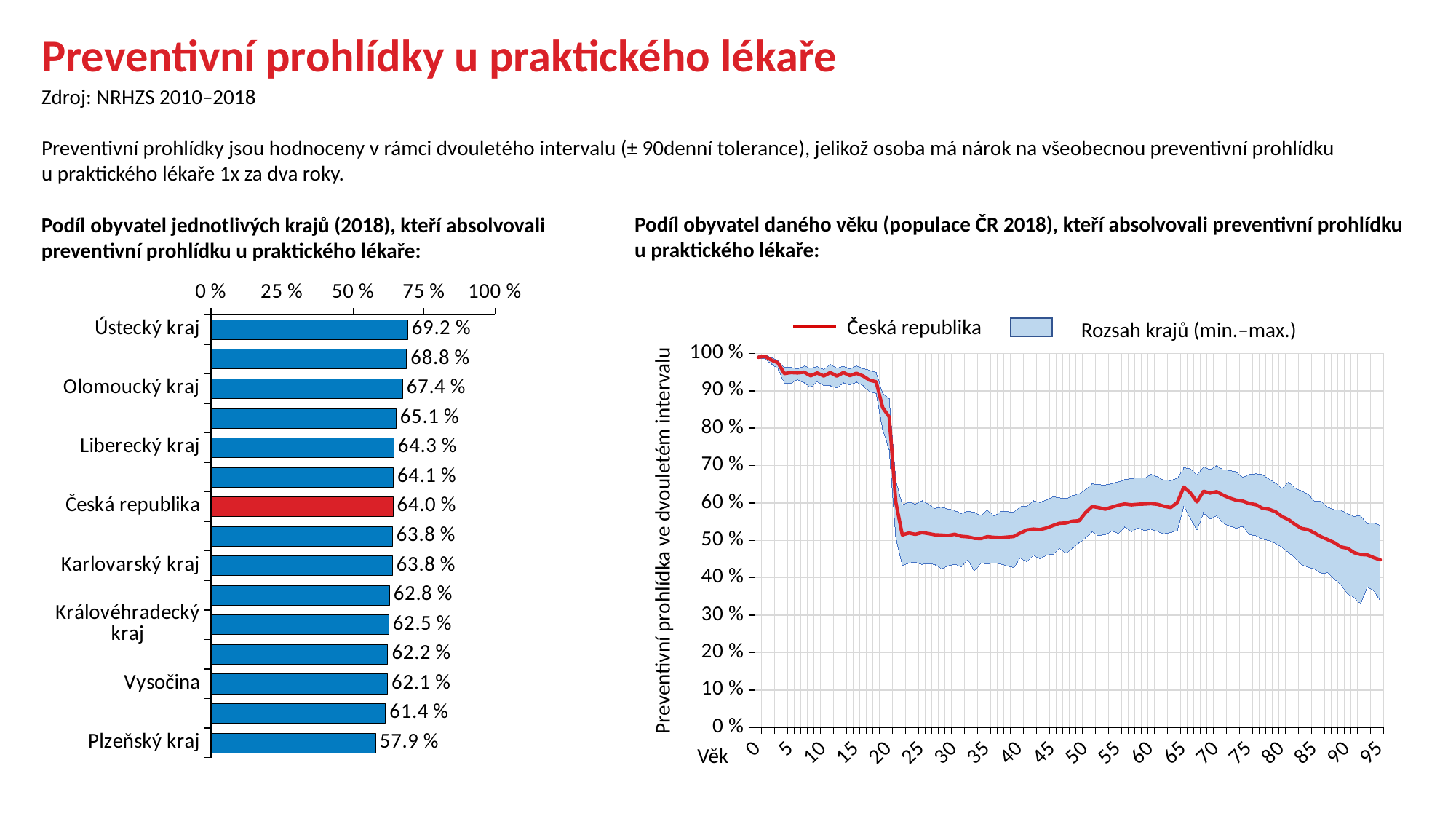
In the right chart, is the Česká republika value at age 0 greater or less than 90 %? greater In the left bar chart, how many bars are plotted? 15 In the left bar chart, which labelled region has the highest value? Ústecký kraj What type of chart is the chart on the left? Bar chart In the left bar chart, what is the value for Ústecký kraj? 69.2 % In the right chart, how many entries does the legend list? 2 In the left bar chart, which is larger: Olomoucký kraj or Liberecký kraj? Olomoucký kraj In the left bar chart, which labelled region has the lowest value? Plzeňský kraj In the left bar chart, what is the difference between Ústecký kraj and Plzeňský kraj? 11.3 % In the left bar chart, what is the value for Plzeňský kraj? 57.9 % In the right chart, is the Česká republika value at age 95 greater or less than 50 %? less In the left bar chart, what is the value for Česká republika? 64.0 %